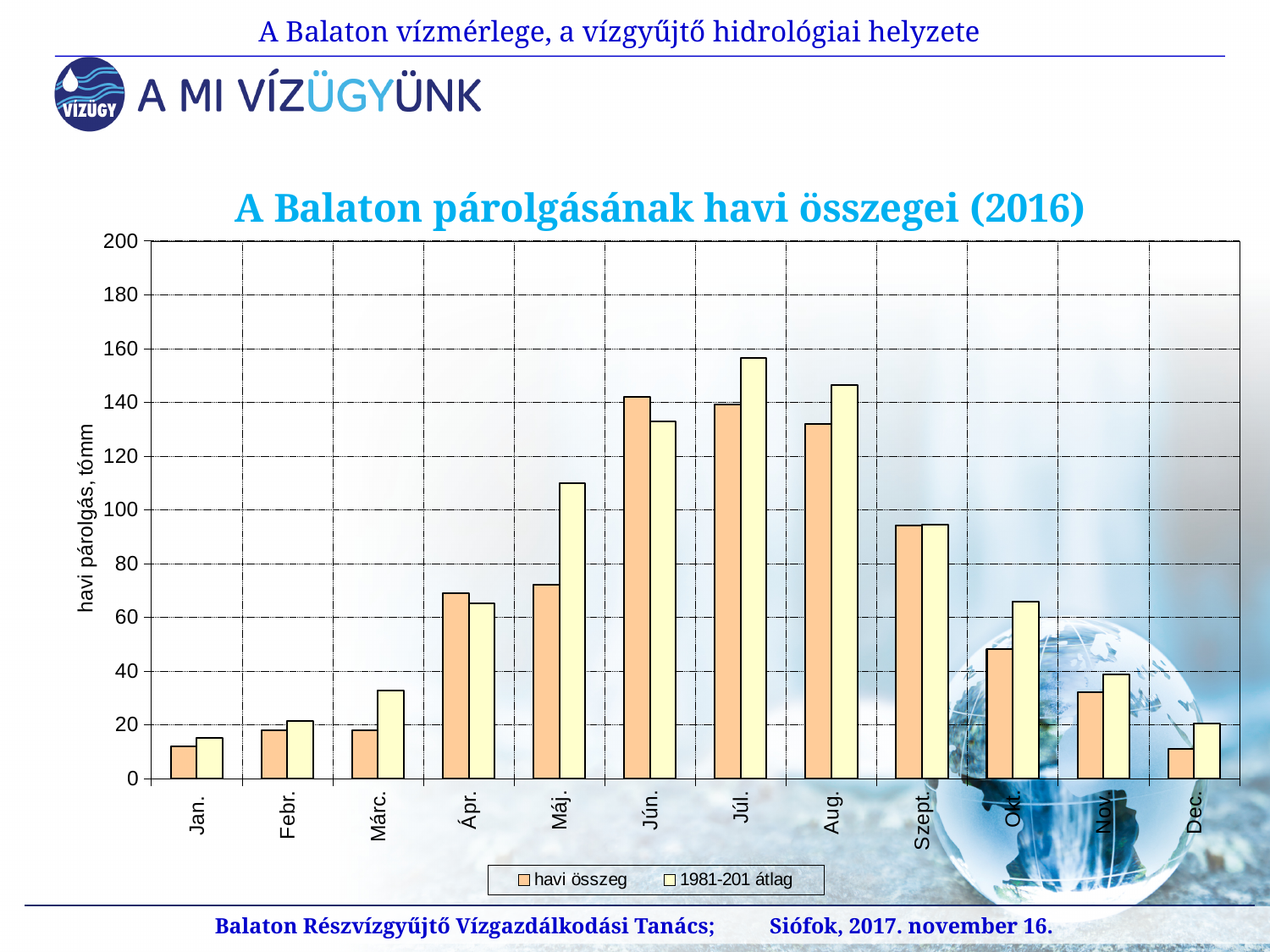
What is the title of the chart? A Balaton párolgásának havi összegei (2016) How many months (categories) are shown on the x axis? 12 Which month has the highest value for the 1981-201 átlag series? Júl. For Máj., which series has the larger value, havi összeg or 1981-201 átlag? 1981-201 átlag Which month has the lowest value for the 1981-201 átlag series? Jan. Is the havi összeg value for Okt. greater or less than 60? less How many series does the legend list? 2 Is the 1981-201 átlag value for Máj. greater or less than 100? greater For Márc., which series has the larger value, havi összeg or 1981-201 átlag? 1981-201 átlag What kind of chart is shown on the slide? bar chart Do the havi összeg values generally rise or fall from Jan. to Jún.? rise Is the havi összeg value for Jún. greater or less than 120? greater